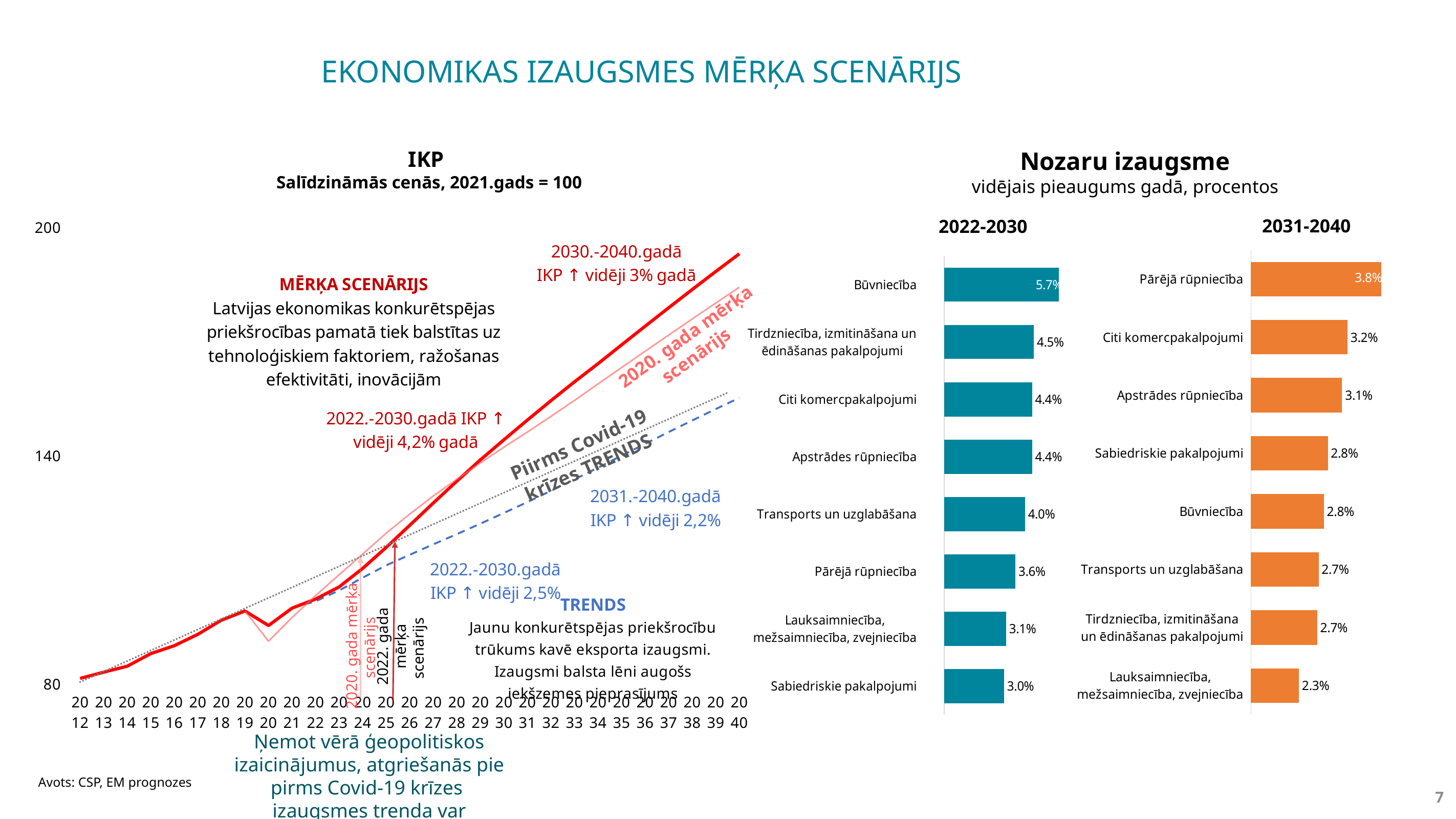
In the 'Nozaru izaugsme' chart for 2022-2030, what is the value for Būvniecība? 5.7% In the 'Nozaru izaugsme' chart for 2031-2040, which sector has the highest value? Pārējā rūpniecība In the 'Nozaru izaugsme' chart for 2031-2040, what is the value for Transports un uzglabāšana? 2.7% In the 'Nozaru izaugsme' chart for 2022-2030, which sector has the lowest value? Sabiedriskie pakalpojumi In the 'IKP' chart, does the red 'mērķa scenārijs' line rise or fall from 2022 to 2040? Rise In the 'Nozaru izaugsme' chart for 2022-2030, what is the difference between Būvniecība and Sabiedriskie pakalpojumi? 2.7% In the 'IKP' chart, is the value of the red 'mērķa scenārijs' line in 2040 greater or less than 140? greater How many sectors are shown in the 'Nozaru izaugsme' chart for 2022-2030? 8 What kind of chart is the 'IKP' chart on the left of the slide? Line chart In the 'Nozaru izaugsme' chart for 2031-2040, what is the difference between Citi komercpakalpojumi and Lauksaimniecība, mežsaimniecība, zvejniecība? 0.9% In the 'Nozaru izaugsme' chart for 2031-2040, what is the value for Pārējā rūpniecība? 3.8% In the 'Nozaru izaugsme' chart for 2022-2030, which is larger: Transports un uzglabāšana or Pārējā rūpniecība? Transports un uzglabāšana